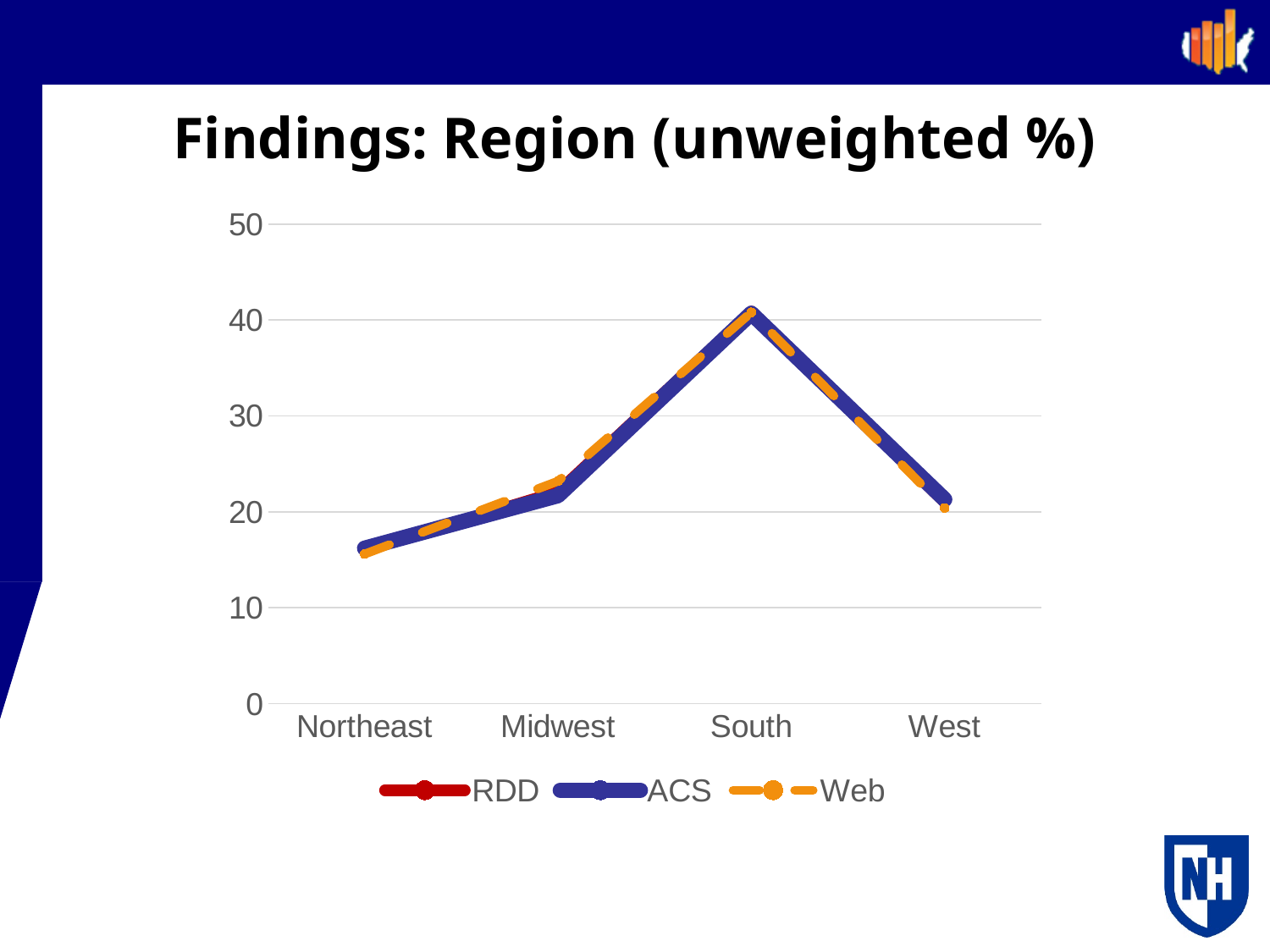
Is the value for Midwest in the RDD series greater or less than 30? less Which region has the lowest value for Web? Northeast Which region has the highest value for ACS? South Is the value for Northeast in the Web series greater or less than 20? less Is the value for West in the ACS series greater or less than 30? less What is the title of the chart? Findings: Region (unweighted %) How many regions are shown on the x axis? 4 Do the values rise or fall from Midwest to South? rise What kind of chart is shown on the slide? line chart How many series does the legend list? 3 Which is larger for the ACS series, the value for South or the value for Midwest? South